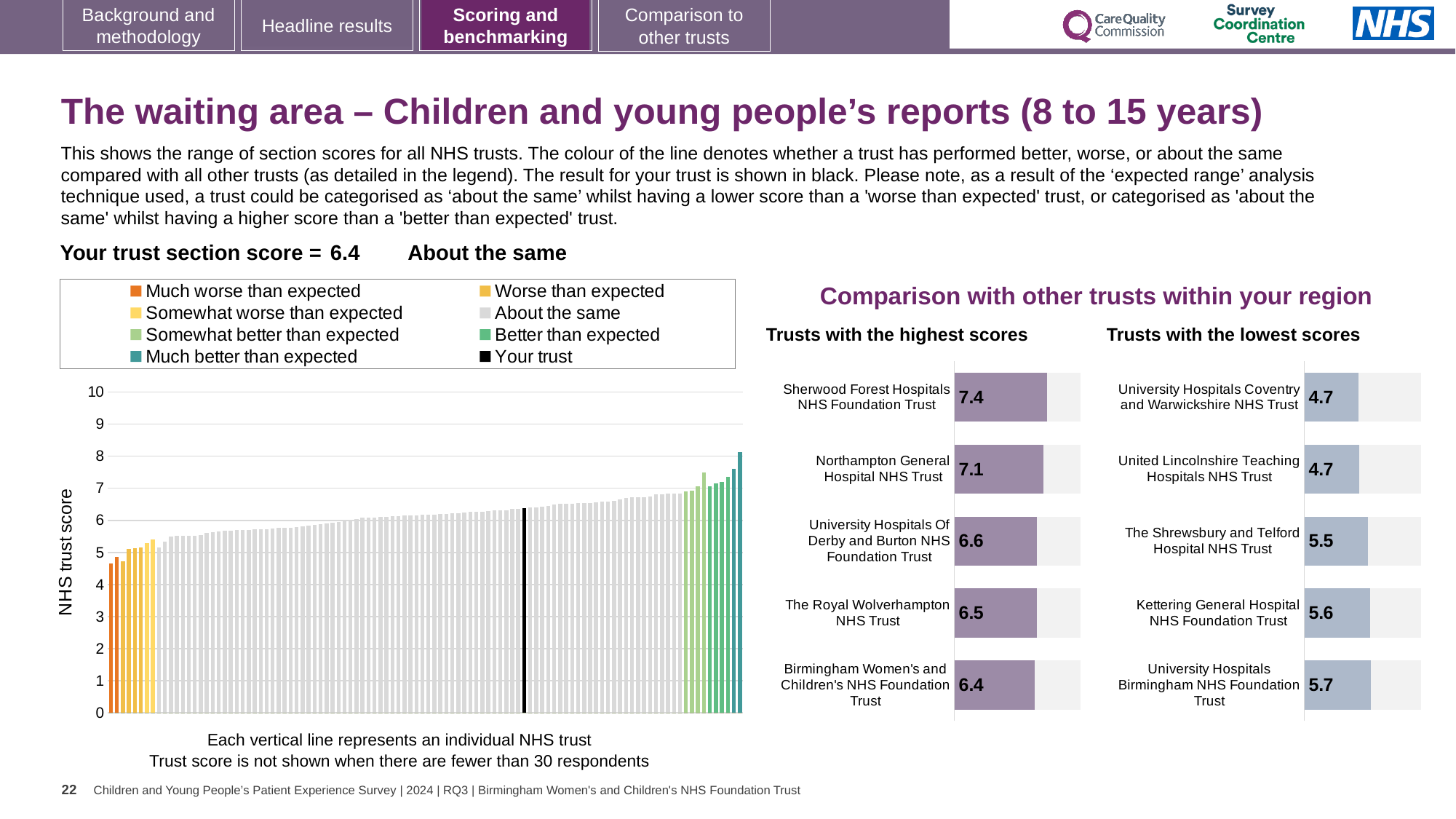
What kind of chart is the main chart of NHS trust scores? bar chart In the main chart of NHS trust scores, is the value for the black 'Your trust' bar greater or less than 6? greater In the 'Trusts with the highest scores' chart, what is the score for Sherwood Forest Hospitals NHS Foundation Trust? 7.4 In the 'Trusts with the highest scores' chart, what is the difference between the scores of Sherwood Forest Hospitals NHS Foundation Trust and Birmingham Women's and Children's NHS Foundation Trust? 1.0 How many entries does the legend of the main chart of NHS trust scores list? 8 In the 'Trusts with the highest scores' chart, which trust has the highest score? Sherwood Forest Hospitals NHS Foundation Trust In the 'Trusts with the lowest scores' chart, which has the larger score: Kettering General Hospital NHS Foundation Trust or The Shrewsbury and Telford Hospital NHS Trust? Kettering General Hospital NHS Foundation Trust How many trusts are shown in the 'Trusts with the highest scores' chart? 5 In the main chart of NHS trust scores, do the bar values rise or fall from left to right? rise In the 'Trusts with the highest scores' chart, what is the score for Northampton General Hospital NHS Trust? 7.1 In the 'Trusts with the lowest scores' chart, what is the score for The Shrewsbury and Telford Hospital NHS Trust? 5.5 In the 'Trusts with the lowest scores' chart, which trust has the highest score? University Hospitals Birmingham NHS Foundation Trust